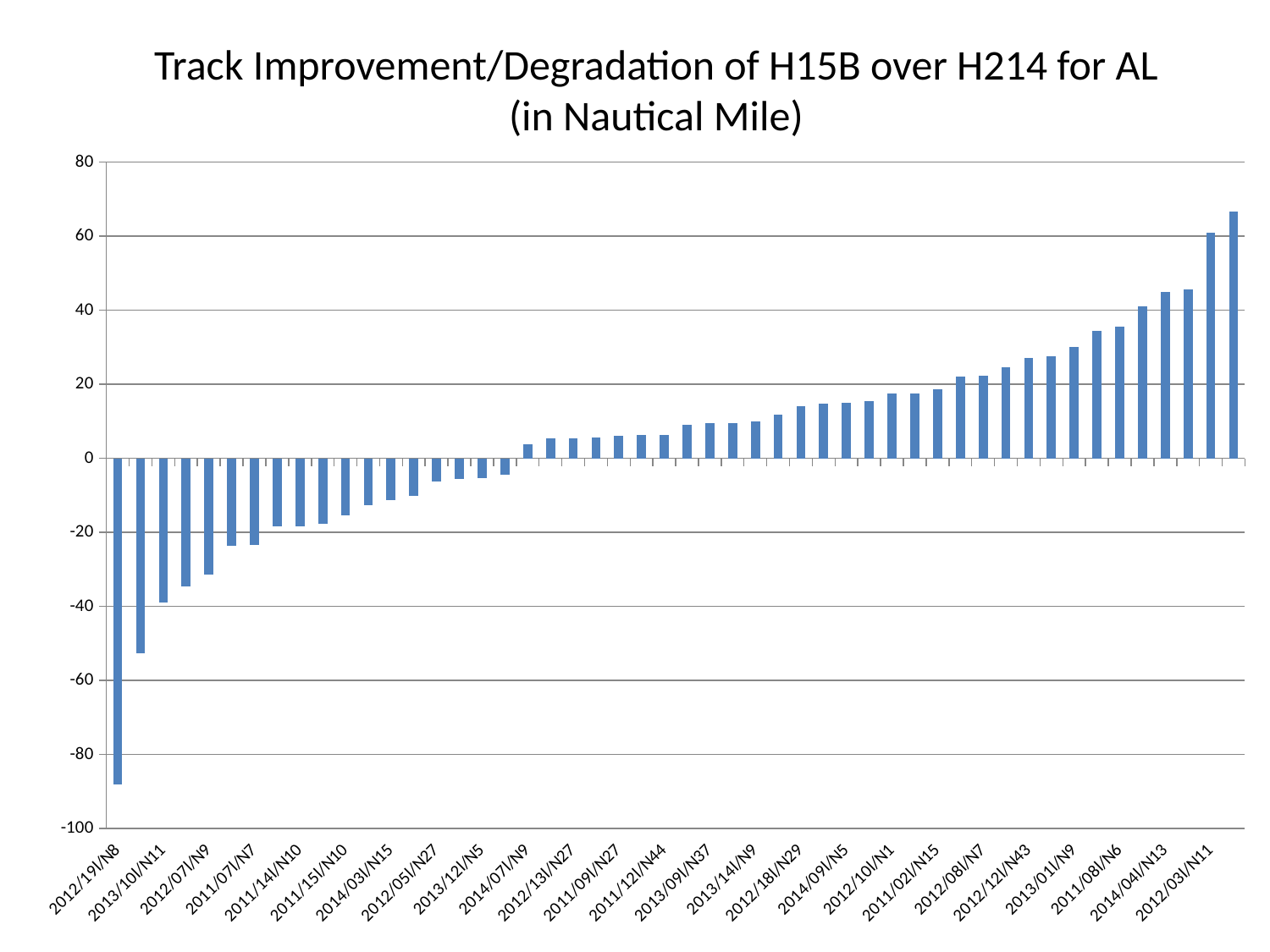
Which category has the lowest value? 2012/19l/N8 Do the values rise or fall moving from left to right along the x axis? rise Is the value for 2012/03/N11 greater or less than 40? greater Which is larger, the value for 2012/19/N8 or the value for 2012/03/N11? 2012/03/N11 Is the value for 2011/07/N7 greater or less than -20? less Is the value for 2014/03/N15 greater or less than -20? greater What kind of chart is shown on the slide? bar chart What is the title of the chart? Track Improvement/Degradation of H15B over H214 for AL (in Nautical Mile)